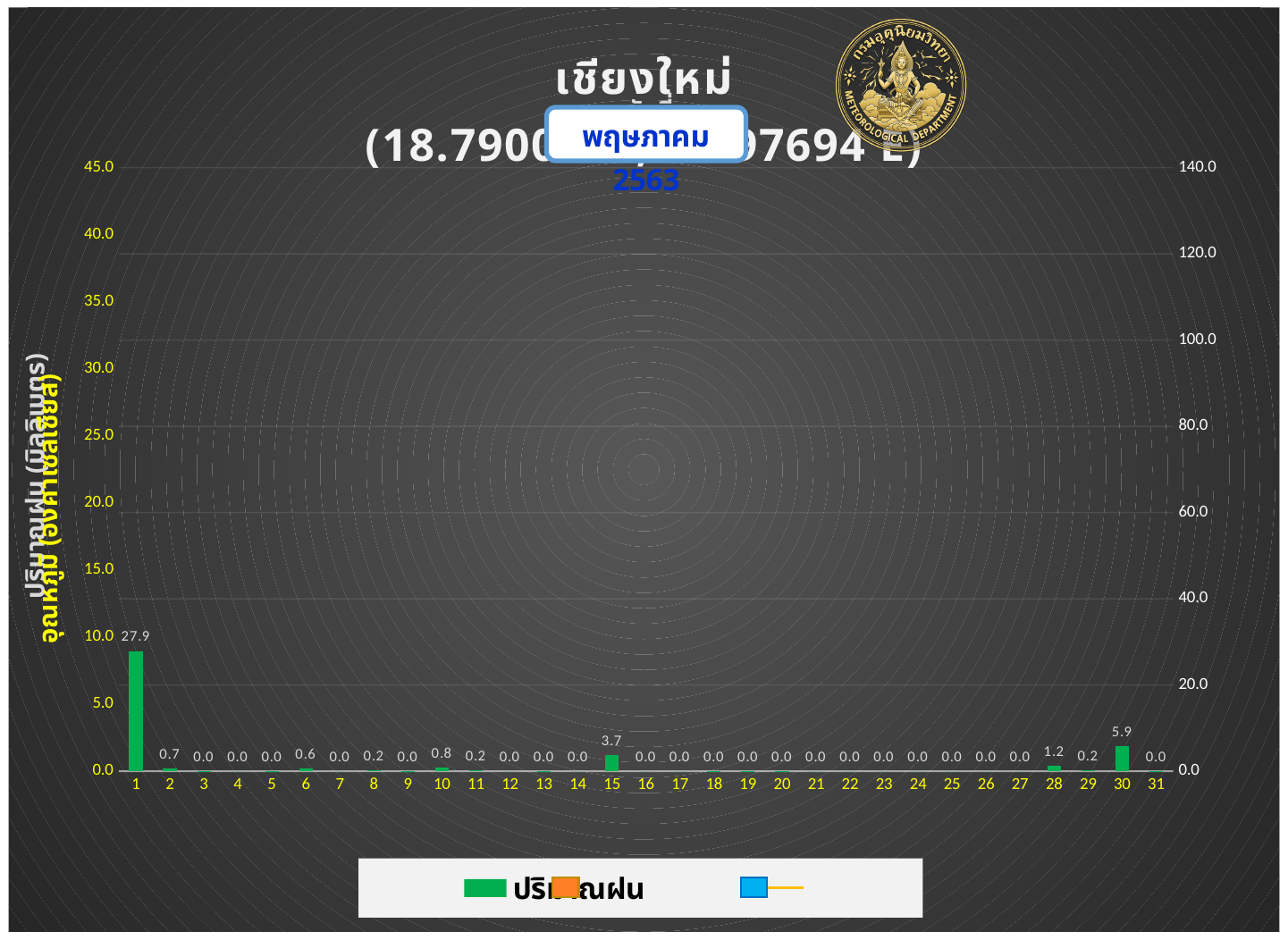
What is the rainfall value shown for day 28? 1.2 Which has the larger rainfall value, day 15 or day 28? day 15 Which has the larger rainfall value, day 2 or day 10? day 10 What is the difference between the rainfall values for day 30 and day 15? 2.2 What kind of chart is shown on the slide? bar chart What is the rainfall value shown for day 10? 0.8 What is the rainfall value shown for day 30? 5.9 What is the rainfall value shown for day 1? 27.9 How many days are shown on the x axis? 31 Which day has the highest rainfall value? 1 What is the difference between the rainfall values for day 1 and day 30? 22.0 What is the rainfall value shown for day 15? 3.7